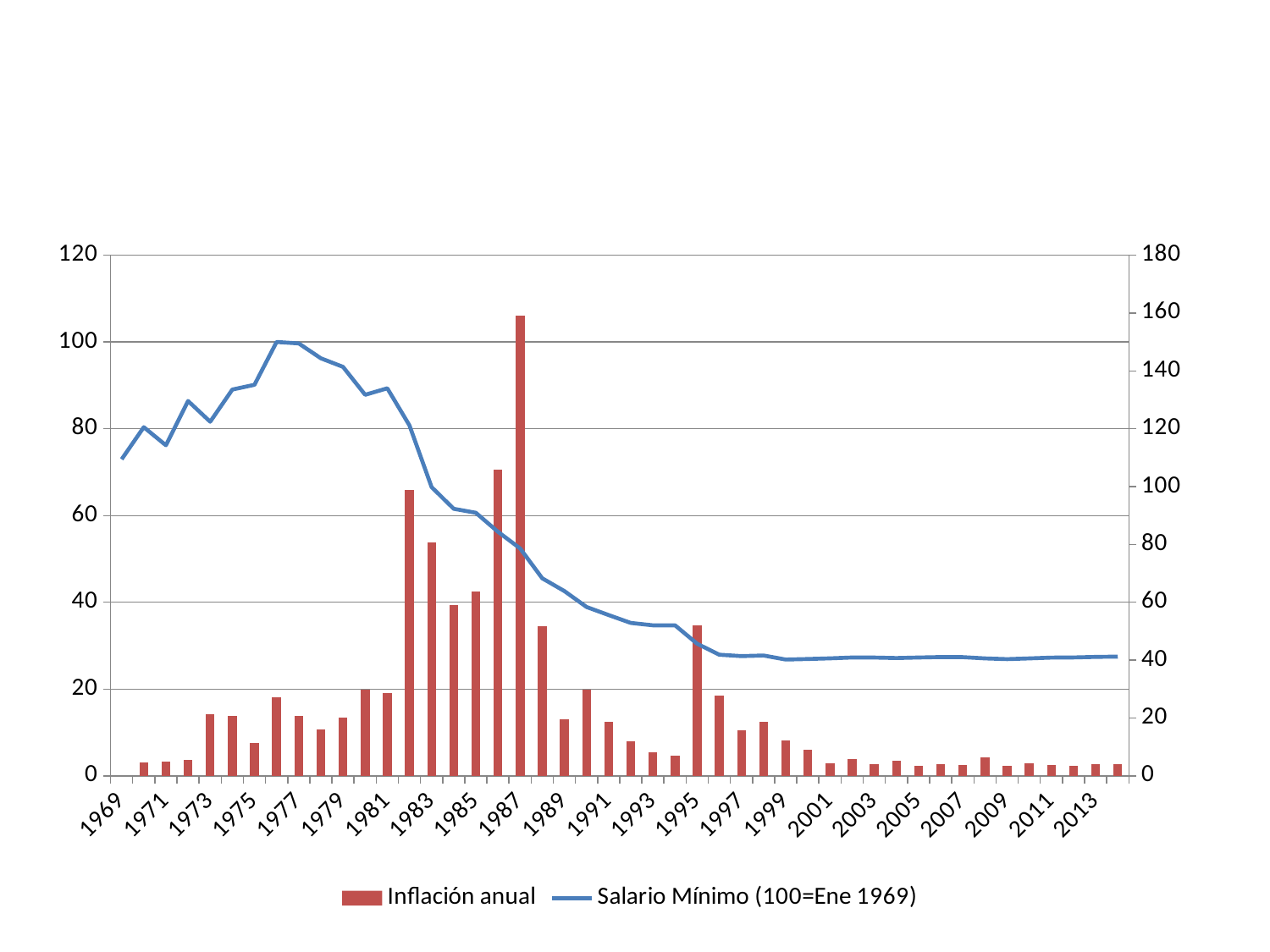
In which year is the Inflación anual bar highest? 1987 What kind of chart is this? Combined bar and line chart Which series is drawn as a line? Salario Mínimo (100=Ene 1969) Is the Inflación anual value for 1986 greater or less than 60? greater Which year has the larger Inflación anual bar, 1982 or 1983? 1982 Is the Salario Mínimo value for 2013 greater or less than 60 on the right axis? less Which series is drawn as bars? Inflación anual Does the Salario Mínimo line rise or fall between 1977 and 2000? fall Is the Inflación anual value for 1987 greater or less than 100? greater How many series does the legend list? 2